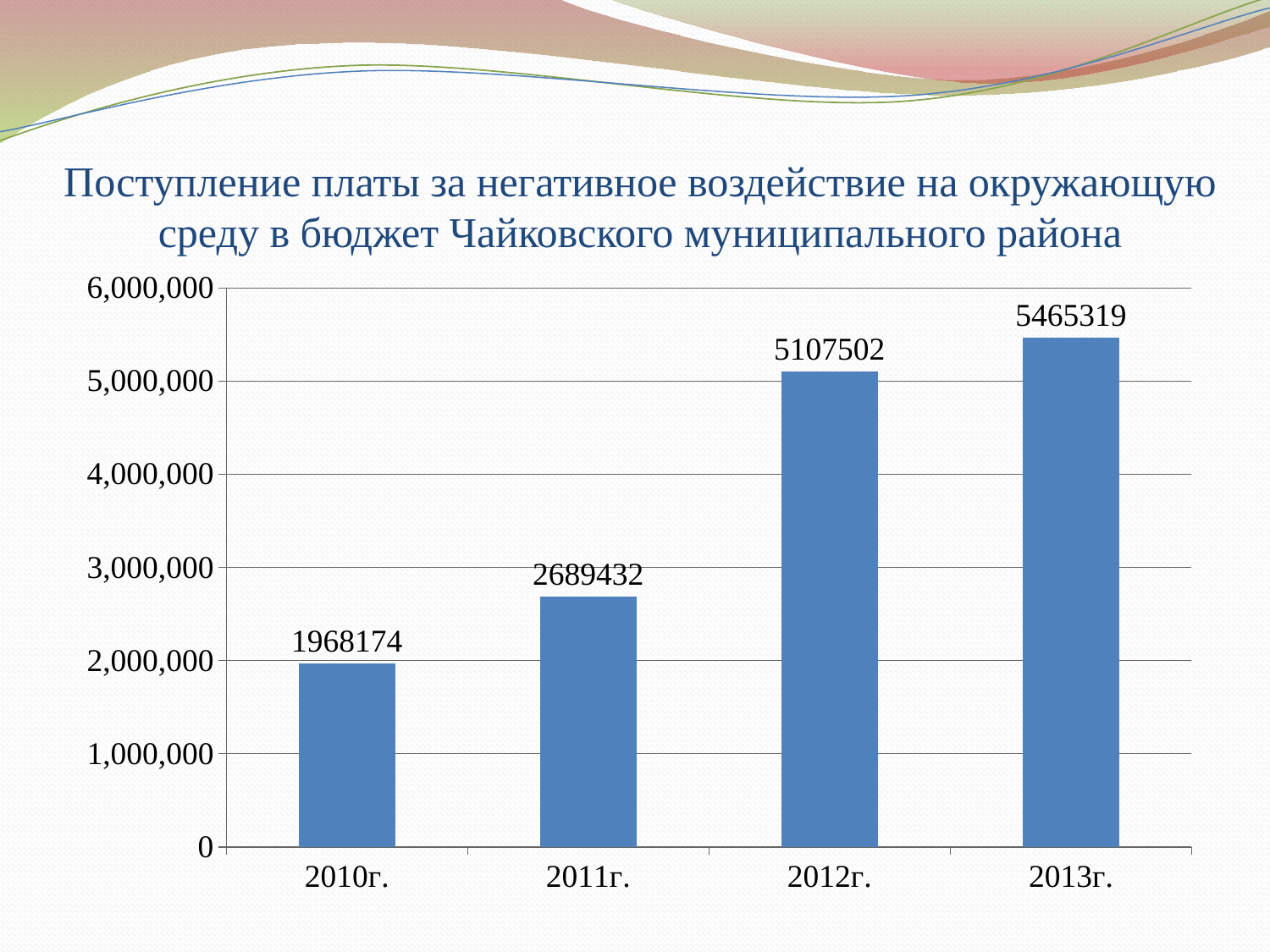
What is the value for 2013г.? 5465319 What is the difference between the values for 2011г. and 2010г.? 721258 How many years are shown on the x axis? 4 What kind of chart is shown on the slide? bar chart Do the values rise or fall from 2010г. to 2013г.? rise What is the value for 2010г.? 1968174 Which year has the lowest value? 2010г. Is the value for 2011г. greater or less than 3,000,000? less Which year has the highest value? 2013г. What is the value for 2012г.? 5107502 What is the difference between the values for 2013г. and 2012г.? 357817 Which is larger, the value for 2011г. or the value for 2012г.? 2012г.